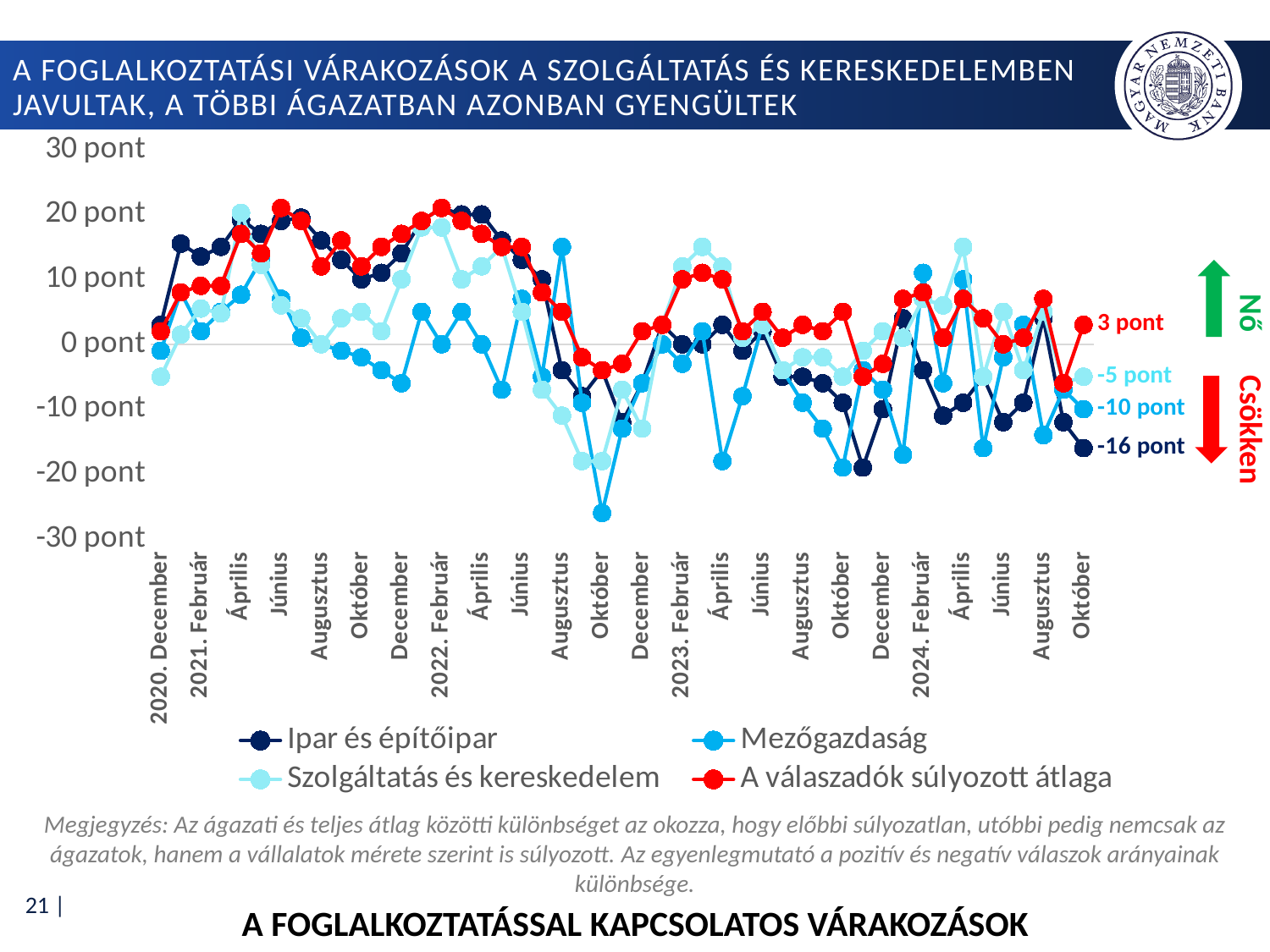
What is the value of 'A válaszadók súlyozott átlaga' at the last point (2024 Október)? 3 pont What kind of chart is shown on the slide? line chart Which series is drawn in red in the legend? A válaszadók súlyozott átlaga How many series does the legend list? 4 What is the value of 'Ipar és építőipar' at the last point (2024 Október)? -16 pont What is the value of 'Szolgáltatás és kereskedelem' at the last point (2024 Október)? -5 pont What is the value of 'Mezőgazdaság' at the last point (2024 Október)? -10 pont Is the value for 'Mezőgazdaság' in 2022 Október greater or less than -20 pont? less What is the difference between the last-point values of 'A válaszadók súlyozott átlaga' (3 pont) and 'Ipar és építőipar' (-16 pont)? 19 pont Which series has the highest value at the last point (2024 Október)? A válaszadók súlyozott átlaga Which series has the lowest value at the last point (2024 Október)? Ipar és építőipar At the last point (2024 Október), which is higher: 'Mezőgazdaság' or 'Ipar és építőipar'? Mezőgazdaság